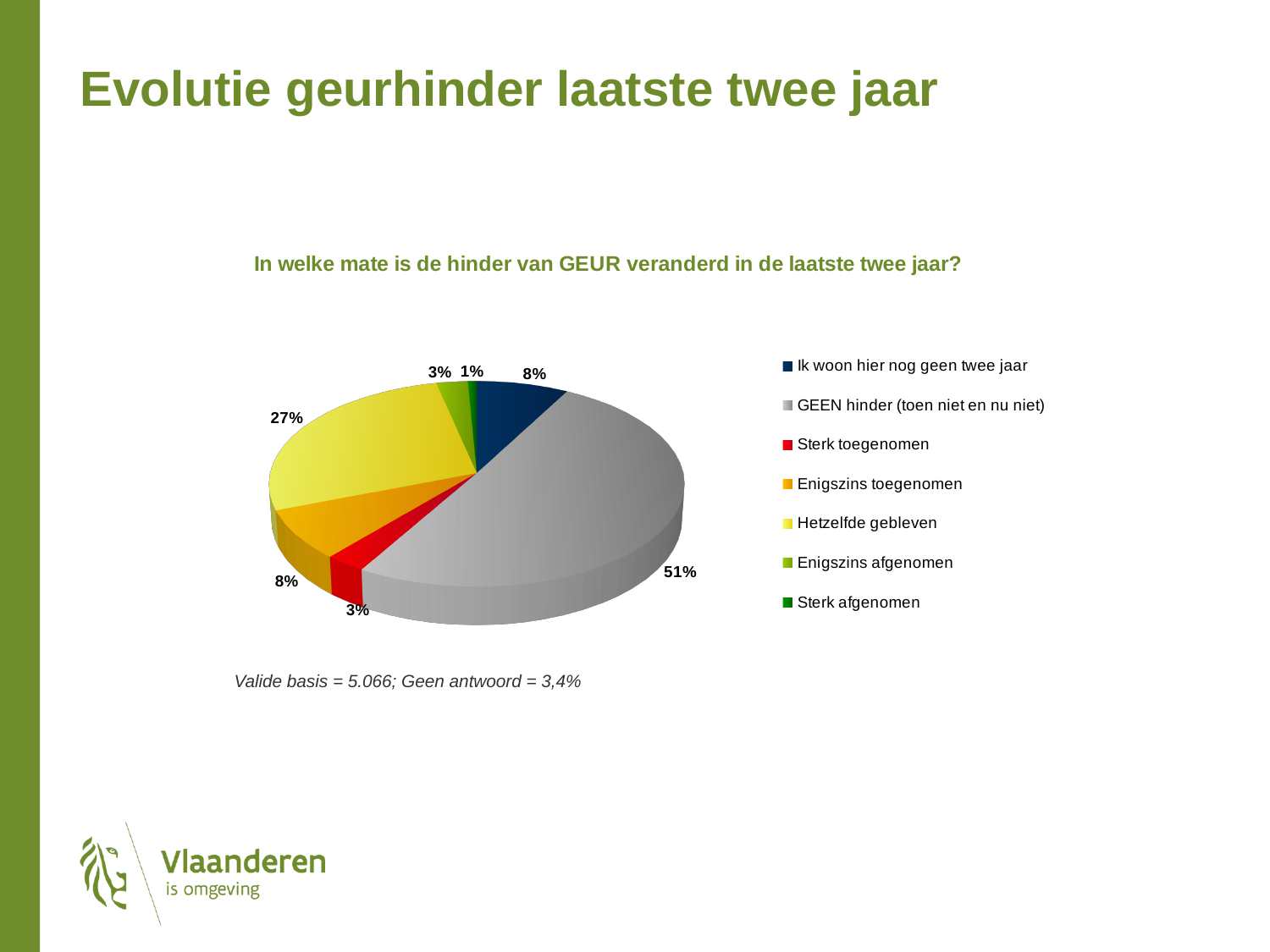
What is the difference between the values for 'GEEN hinder (toen niet en nu niet)' and 'Hetzelfde gebleven'? 24% Which category has the largest slice of the pie? GEEN hinder (toen niet en nu niet) How many categories does the pie chart have? 7 What question is shown as the chart's title? In welke mate is de hinder van GEUR veranderd in de laatste twee jaar? What is the value for 'Enigszins toegenomen'? 8% Which is larger, the value for 'Enigszins toegenomen' or the value for 'Sterk toegenomen'? Enigszins toegenomen What type of chart is shown on the slide? pie chart What is the value for 'Ik woon hier nog geen twee jaar'? 8% What share of the pie does 'GEEN hinder (toen niet en nu niet)' represent? 51% Which category has the smallest slice of the pie? Sterk afgenomen What is the value for 'Sterk afgenomen'? 1% What is the value for 'Hetzelfde gebleven'? 27%